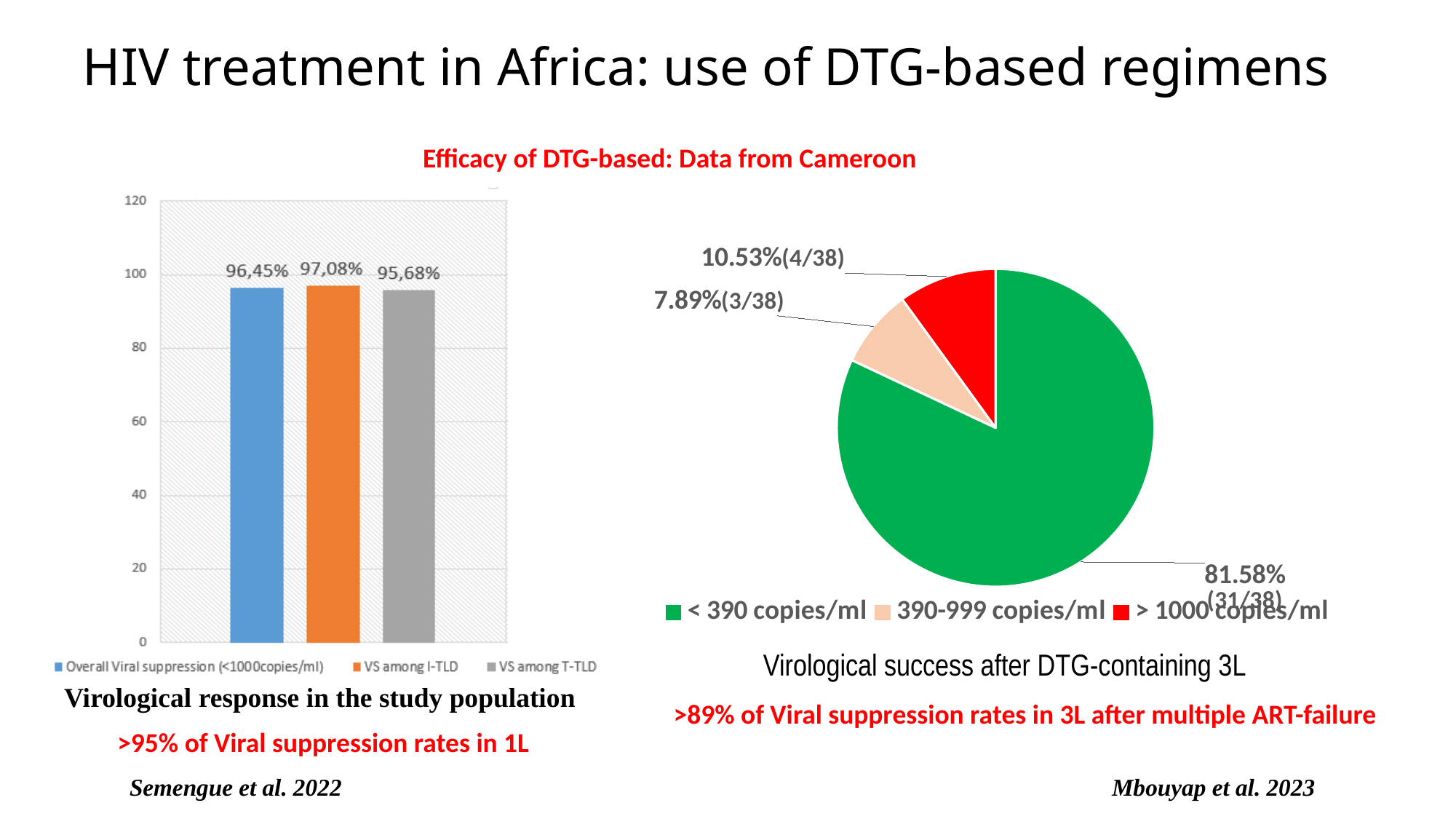
In the bar chart on the left, which series has the highest value? VS among I-TLD In the bar chart on the left, what is the value for VS among T-TLD? 95,68% In the pie chart on the right, how many categories does the legend list? 3 In the bar chart on the left, how many series does the legend list? 3 In the bar chart on the left, what is the value for Overall Viral suppression (<1000copies/ml)? 96,45% In the bar chart on the left, which series has the lowest value? VS among T-TLD In the pie chart on the right, what share of the pie is 390-999 copies/ml? 7.89% In the bar chart on the left, what is the value for VS among I-TLD? 97,08% In the pie chart on the right, what share of the pie is > 1000 copies/ml? 10.53% In the pie chart on the right, which category has the smallest slice? 390-999 copies/ml What kind of chart is the chart on the left of the slide? Bar chart In the pie chart on the right, what share of the pie is < 390 copies/ml? 81.58%